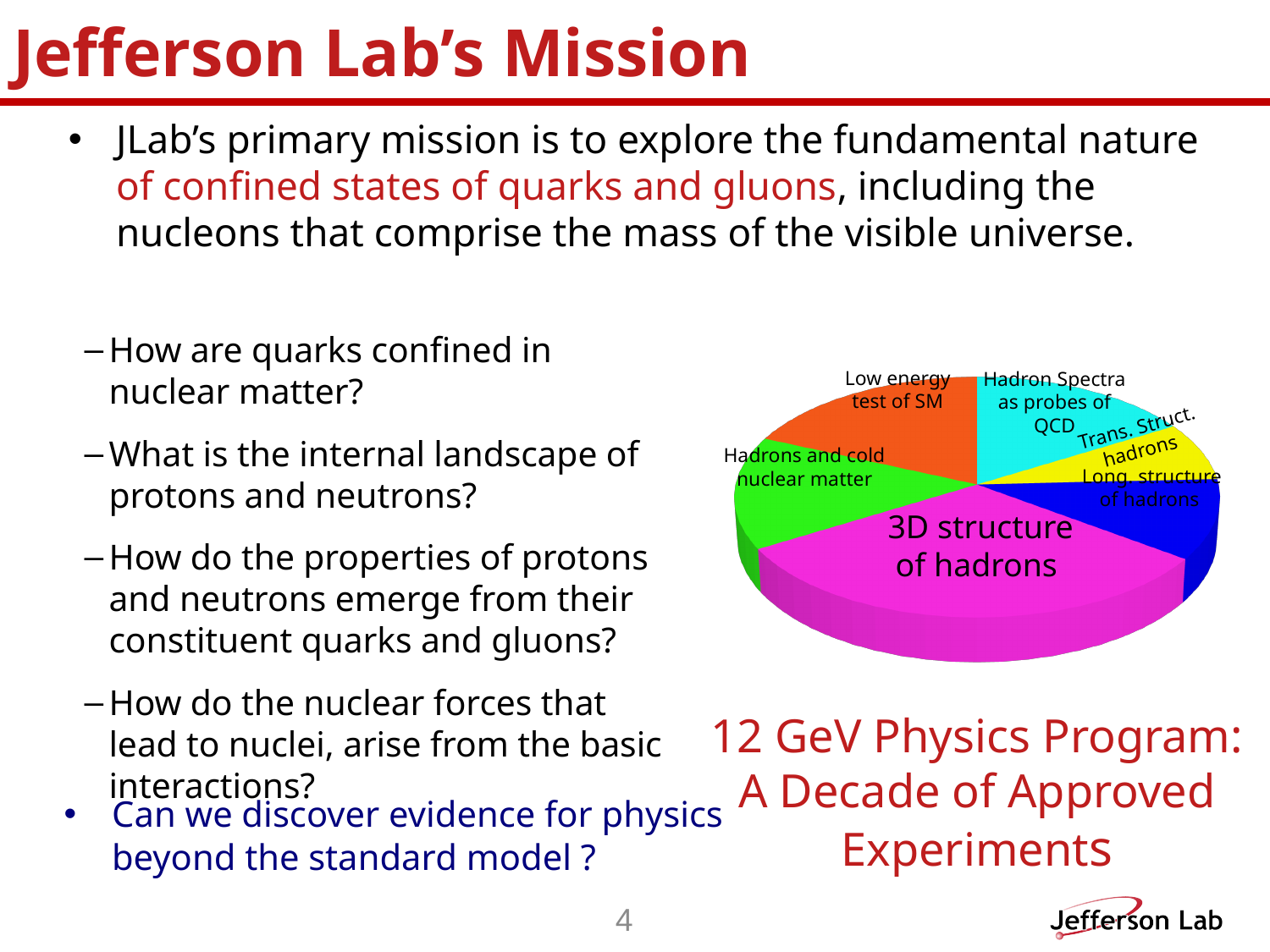
Which slice is larger: Low energy test of SM or Long. structure of hadrons? Low energy test of SM Which slice is larger: Hadrons and cold nuclear matter or Trans. Struct. hadrons? Hadrons and cold nuclear matter Which slice of the pie chart is the largest? 3D structure of hadrons What colour is the 3D structure of hadrons slice in the pie chart? magenta Which slice of the pie chart is the smallest? Trans. Struct. hadrons What caption appears below the pie chart? 12 GeV Physics Program: A Decade of Approved Experiments Which slice is larger: Hadron Spectra as probes of QCD or 3D structure of hadrons? 3D structure of hadrons How many slices does the pie chart have? 6 What kind of chart is shown on the slide? pie chart